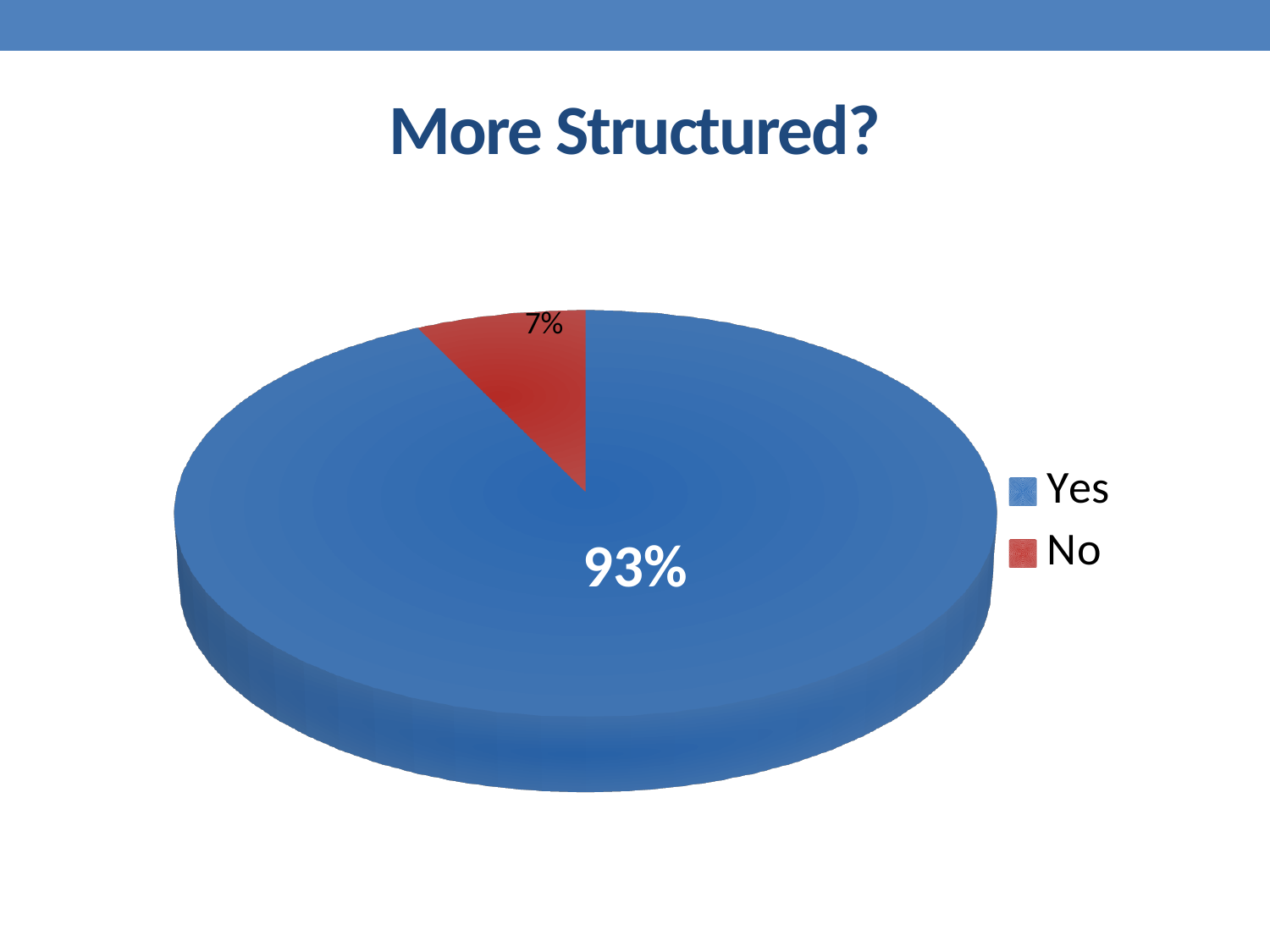
What percentage of the pie chart is labelled "No"? 7% What colour is the "No" slice in the pie chart? Red What kind of chart is shown on the slide? Pie chart What is the title of the chart on the slide? More Structured? What share of the pie does the "No" slice represent? 7% Which slice is larger, "Yes" or "No"? Yes How many categories does the pie chart show? 2 What is the difference in percentage points between the "Yes" and "No" slices? 86 What percentage of the pie chart is labelled "Yes"? 93% Which category has the smallest share of the pie chart? No Which category has the largest share of the pie chart? Yes